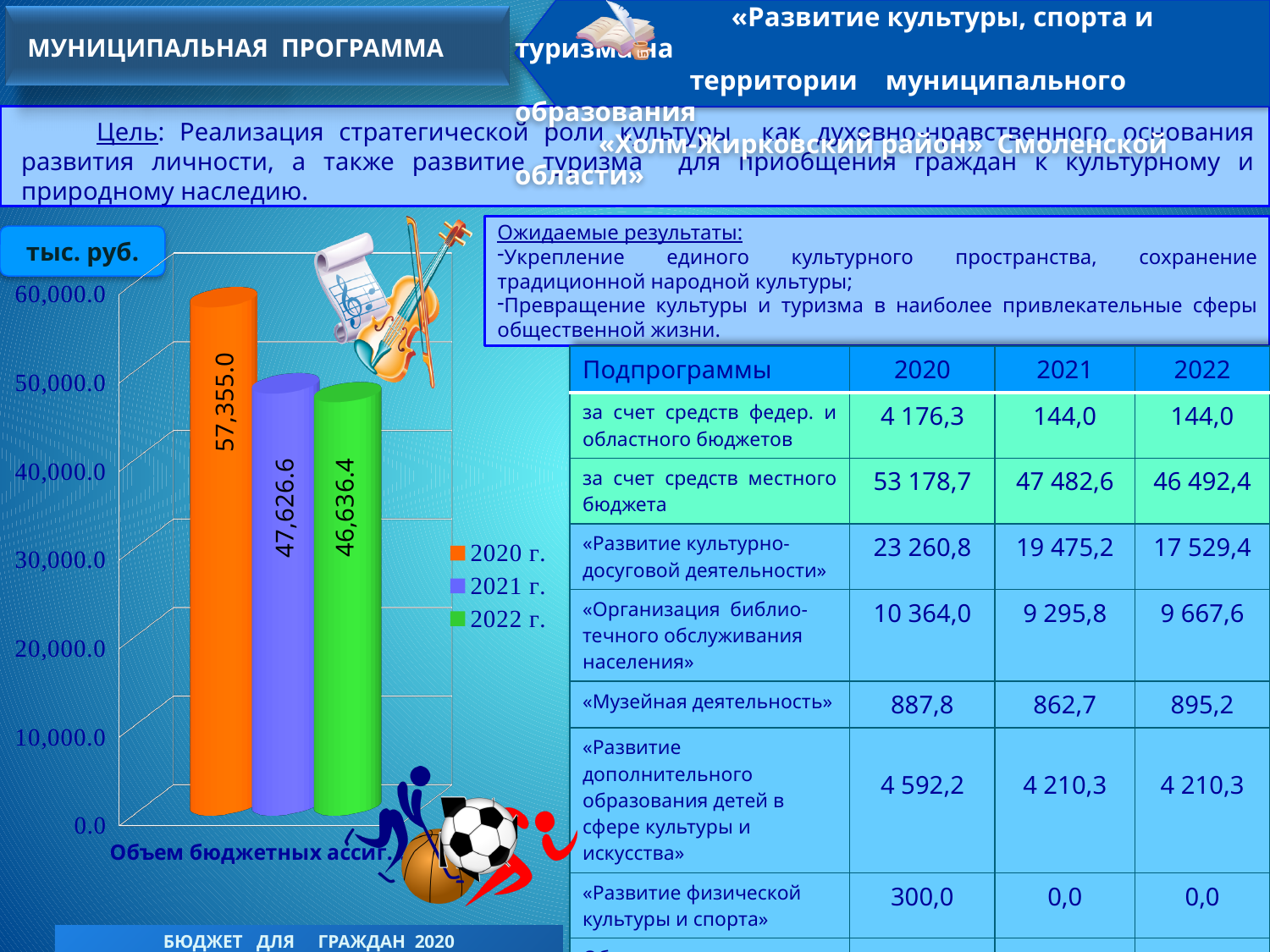
What kind of chart is shown on the slide? bar chart What is the value shown for 2022 г. on the chart? 46,636.4 Which is larger, the value for 2020 г. or the value for 2022 г.? 2020 г. What is the value shown for 2020 г. on the chart? 57,355.0 Do the values rise or fall from 2020 г. to 2022 г.? fall What is the difference between the values for 2020 г. and 2021 г.? 9,728.4 How many series does the chart legend list? 3 What is the value shown for 2021 г. on the chart? 47,626.6 Is the value for 2022 г. greater or less than 50,000.0? less What is the difference between the values for 2021 г. and 2022 г.? 990.2 Which year has the highest value on the chart? 2020 г. Which year has the lowest value on the chart? 2022 г.